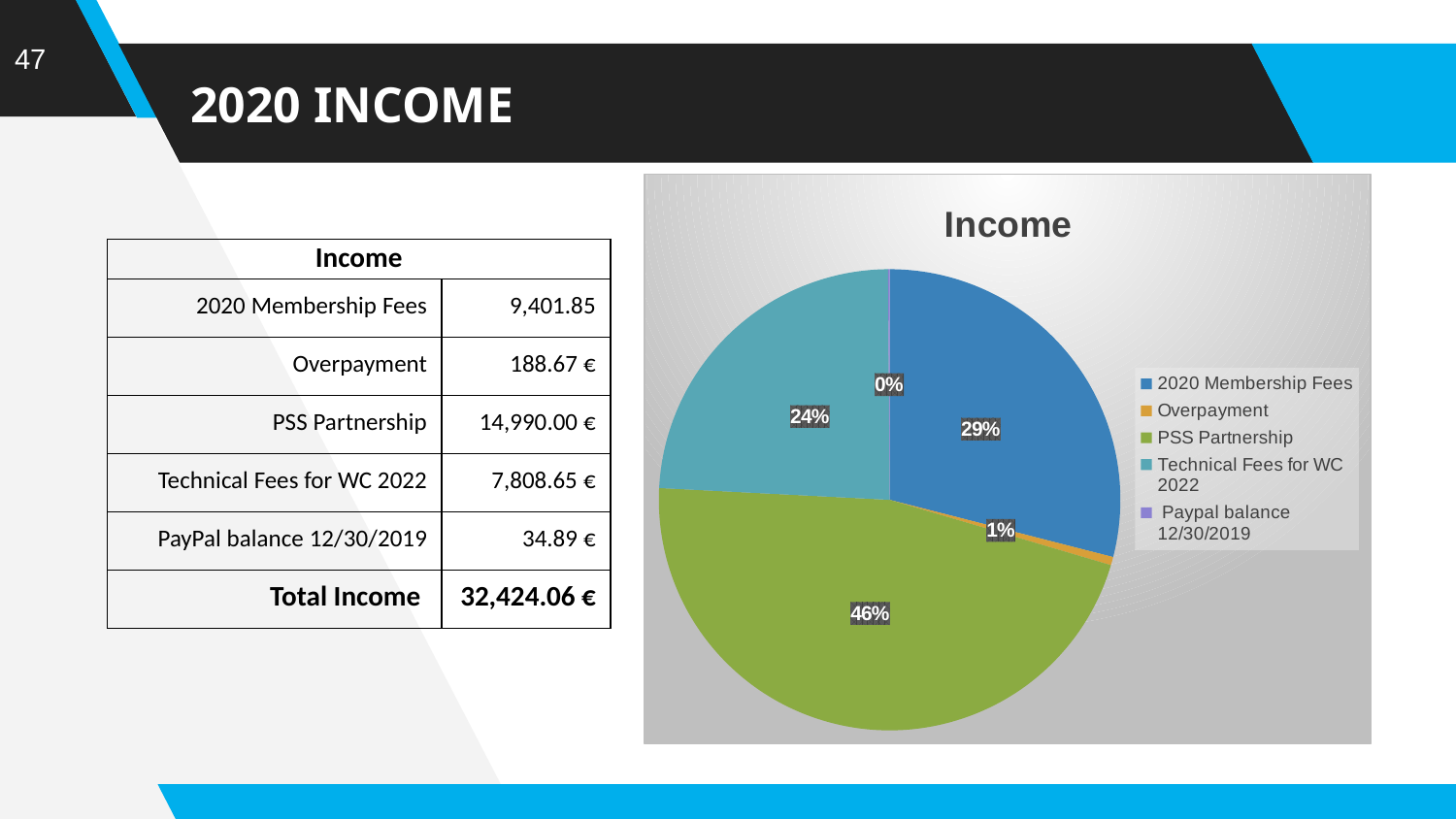
What kind of chart is shown on the slide? pie chart Which category has the largest slice of the pie? PSS Partnership What share of the pie does PSS Partnership take? 46% Which category has the smallest slice of the pie? Paypal balance 12/30/2019 What share of the pie does Technical Fees for WC 2022 take? 24% What is the difference in percentage points between the PSS Partnership slice and the 2020 Membership Fees slice? 17% What share of the pie does Paypal balance 12/30/2019 take? 0% How many entries does the legend list? 5 What is the chart's title? Income Which is larger, the slice for 2020 Membership Fees or the slice for Technical Fees for WC 2022? 2020 Membership Fees